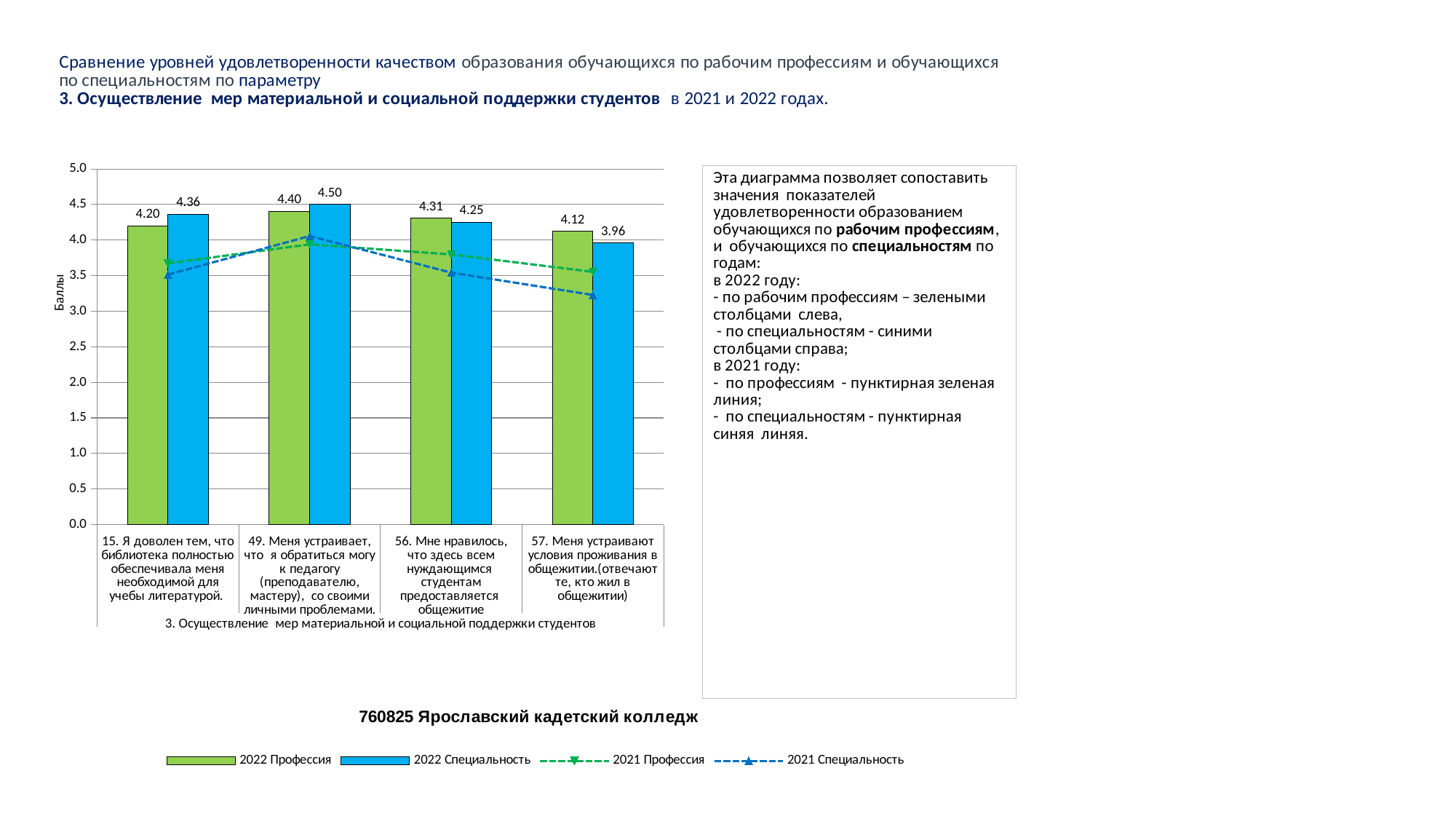
What is the difference between the 2022 Специальность and 2022 Профессия values for question 15? 0.16 What is the 2022 Специальность value for question 49 (contacting a teacher)? 4.50 What is the label of the y axis? Баллы Which question has the lowest 2022 Специальность value? 57. Меня устраивают условия проживания в общежитии What is the 2022 Профессия value for question 15 (library)? 4.20 Which question has the highest 2022 Профессия value? 49. Меня устраивает, что я обратиться могу к педагогу For question 56, which is larger: the 2022 Профессия value or the 2022 Специальность value? 2022 Профессия What is the 2022 Специальность value for question 57 (dormitory living conditions)? 3.96 How many question categories are shown on the x axis? 4 What kind of chart is used for the 2022 values? bar chart How many series does the legend list? 4 Is the 2021 Специальность value for question 57 greater or less than 3.5? less